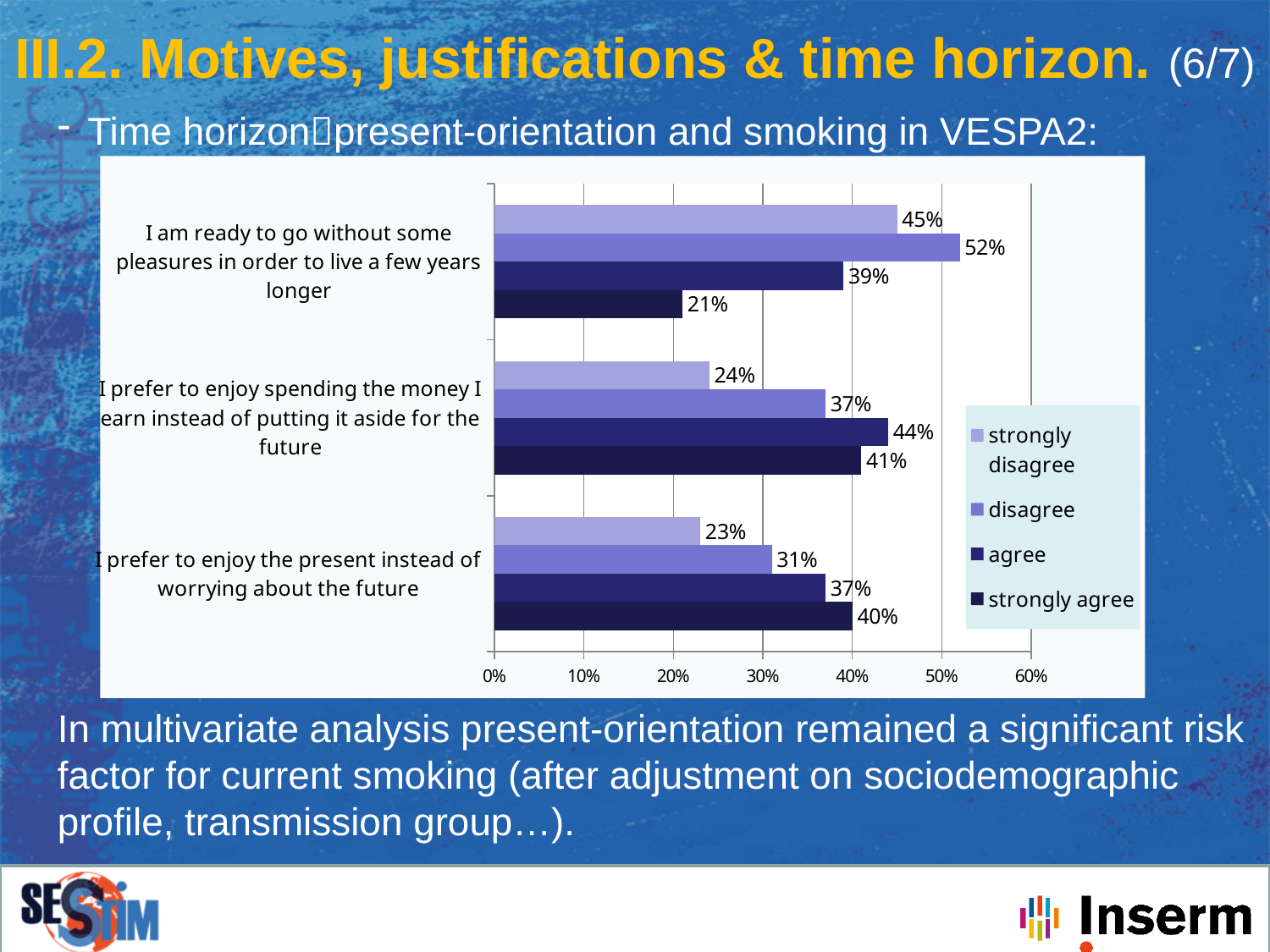
Which response category has the highest value for the statement "I am ready to go without some pleasures in order to live a few years longer"? disagree For the statement "I prefer to enjoy spending the money I earn instead of putting it aside for the future", which is larger: the "disagree" value or the "strongly agree" value? strongly agree What is the value for "strongly agree" for the statement "I prefer to enjoy the present instead of worrying about the future"? 40% What is the value for "strongly disagree" for the statement "I am ready to go without some pleasures in order to live a few years longer"? 45% Which response category has the lowest value for the statement "I prefer to enjoy the present instead of worrying about the future"? strongly disagree How many series does the legend list? 4 Is the "disagree" value for the statement "I am ready to go without some pleasures in order to live a few years longer" greater or less than 50%? greater What is the difference between the "disagree" and "strongly agree" values for the statement "I am ready to go without some pleasures in order to live a few years longer"? 31% What is the value for "agree" for the statement "I prefer to enjoy spending the money I earn instead of putting it aside for the future"? 44% What kind of chart is shown on the slide? bar chart How many statements (categories) are shown on the chart? 3 What is the maximum value shown on the horizontal axis of the chart? 60%